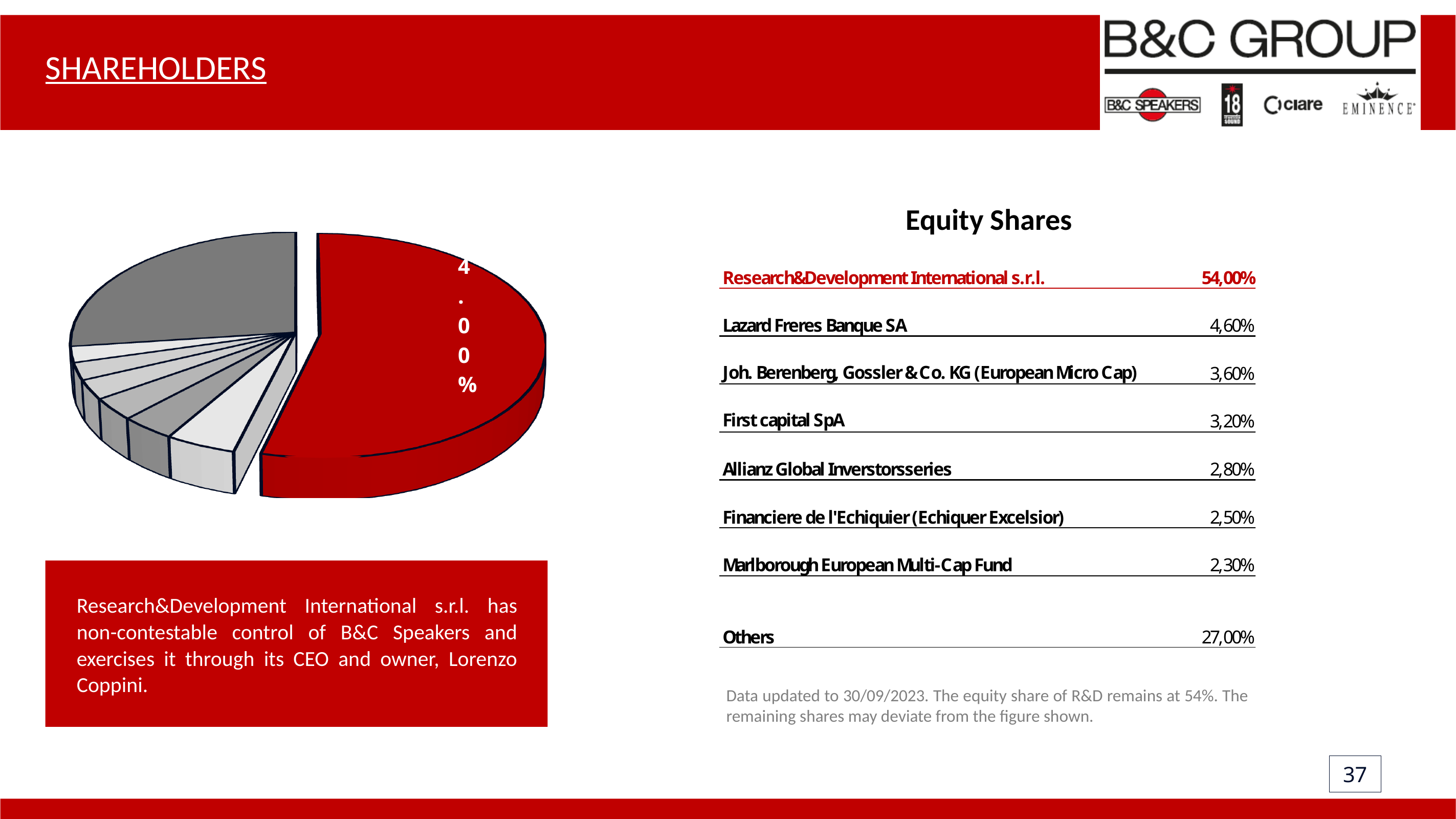
How many slices does the pie chart have? 8 Does the pie chart have a legend? no Is the red slice of the pie chart pulled out (exploded) from the rest of the pie? yes What kind of chart is shown on the left of the slide? pie chart What colour is the largest slice of the pie chart? red